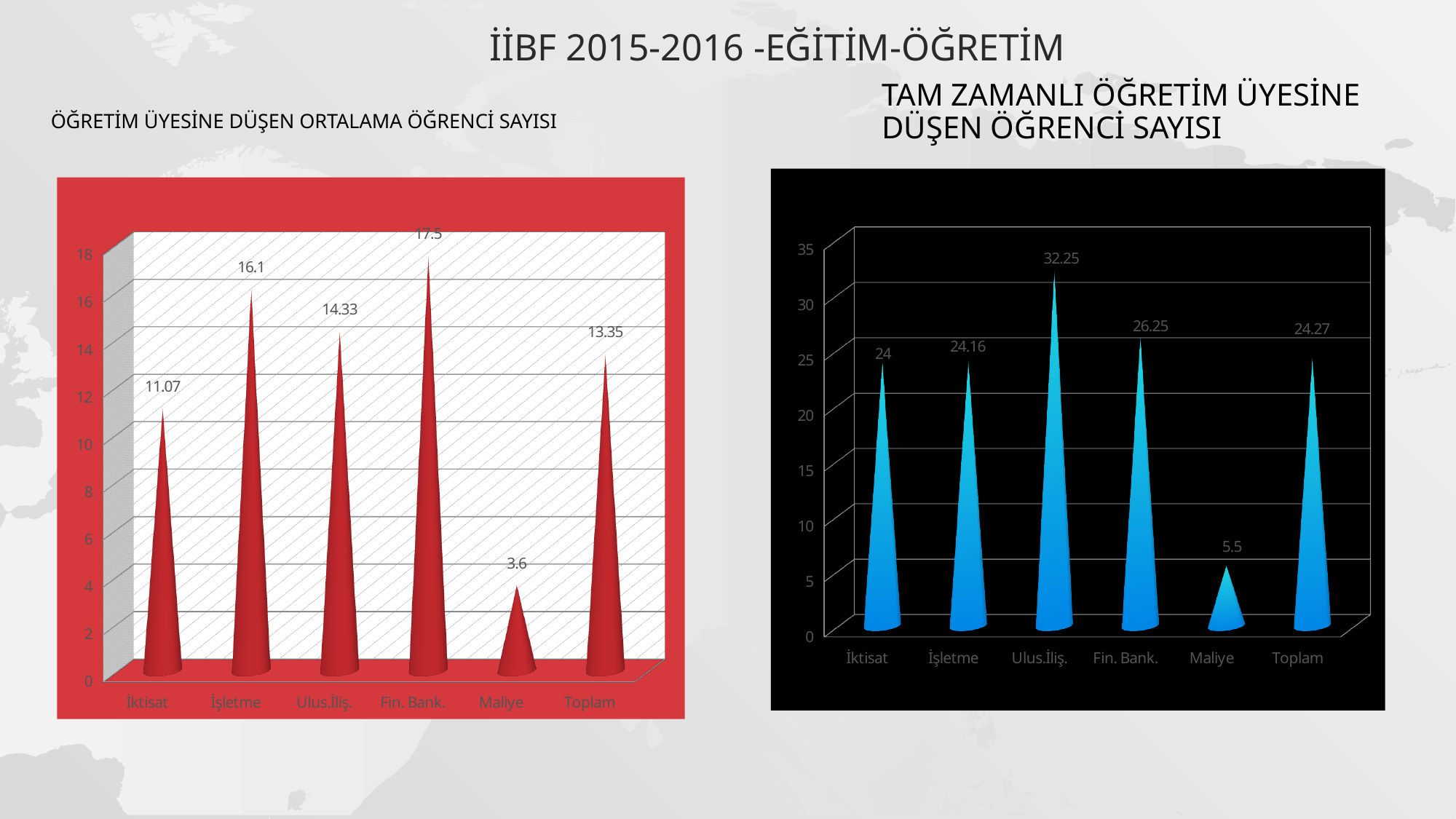
In the left chart (ÖĞRETİM ÜYESİNE DÜŞEN ORTALAMA ÖĞRENCİ SAYISI), what is the value for İktisat? 11.07 What kind of chart is the right chart (TAM ZAMANLI ÖĞRETİM ÜYESİNE DÜŞEN ÖĞRENCİ SAYISI)? Bar chart How many categories are shown on the x axis of the left chart (ÖĞRETİM ÜYESİNE DÜŞEN ORTALAMA ÖĞRENCİ SAYISI)? 6 In the right chart (TAM ZAMANLI ÖĞRETİM ÜYESİNE DÜŞEN ÖĞRENCİ SAYISI), what is the difference between Ulus.İliş. and Maliye? 26.75 In the right chart (TAM ZAMANLI ÖĞRETİM ÜYESİNE DÜŞEN ÖĞRENCİ SAYISI), what is the value for Ulus.İliş.? 32.25 In the right chart (TAM ZAMANLI ÖĞRETİM ÜYESİNE DÜŞEN ÖĞRENCİ SAYISI), what is the value for Toplam? 24.27 In the left chart (ÖĞRETİM ÜYESİNE DÜŞEN ORTALAMA ÖĞRENCİ SAYISI), what is the value for Fin. Bank.? 17.5 In the right chart (TAM ZAMANLI ÖĞRETİM ÜYESİNE DÜŞEN ÖĞRENCİ SAYISI), which is larger, Fin. Bank. or İktisat? Fin. Bank. In the right chart (TAM ZAMANLI ÖĞRETİM ÜYESİNE DÜŞEN ÖĞRENCİ SAYISI), which category has the highest value? Ulus.İliş. In the left chart (ÖĞRETİM ÜYESİNE DÜŞEN ORTALAMA ÖĞRENCİ SAYISI), which category has the highest value? Fin. Bank. In the left chart (ÖĞRETİM ÜYESİNE DÜŞEN ORTALAMA ÖĞRENCİ SAYISI), which category has the lowest value? Maliye In the left chart (ÖĞRETİM ÜYESİNE DÜŞEN ORTALAMA ÖĞRENCİ SAYISI), what is the difference between İşletme and Ulus.İliş.? 1.77